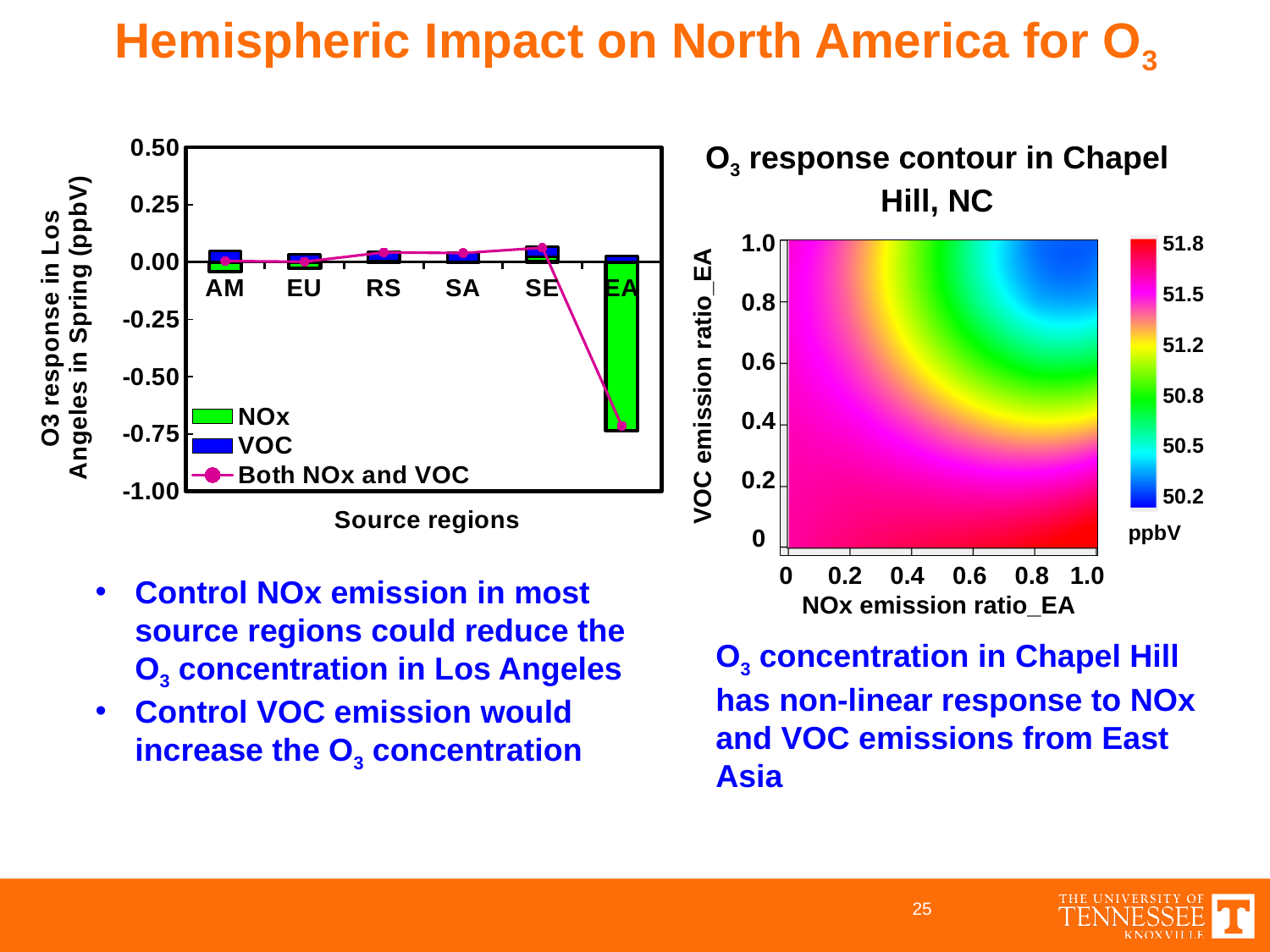
In the left chart, is the NOx value for SE greater or less than 0.25? less In the left chart, what are the three legend entries? NOx, VOC, Both NOx and VOC In the right chart (O3 response contour in Chapel Hill, NC), what is the highest value shown on the colour scale? 51.8 In the left chart, which source region has the lowest NOx value? EA In the right chart (O3 response contour in Chapel Hill, NC), what is the lowest value shown on the colour scale? 50.2 What kind of chart is the left chart showing O3 response in Los Angeles? bar and line chart In the left chart, how many series does the legend list? 3 In the left chart, is the 'Both NOx and VOC' value for EA greater or less than -0.50? less In the left chart, is the NOx value for EA greater or less than -0.50? less In the left chart, how many source regions are shown on the x axis? 6 In the right chart (O3 response contour in Chapel Hill, NC), what is the label of the x axis? NOx emission ratio_EA In the left chart, which is larger, the NOx value for AM or the NOx value for EA? AM